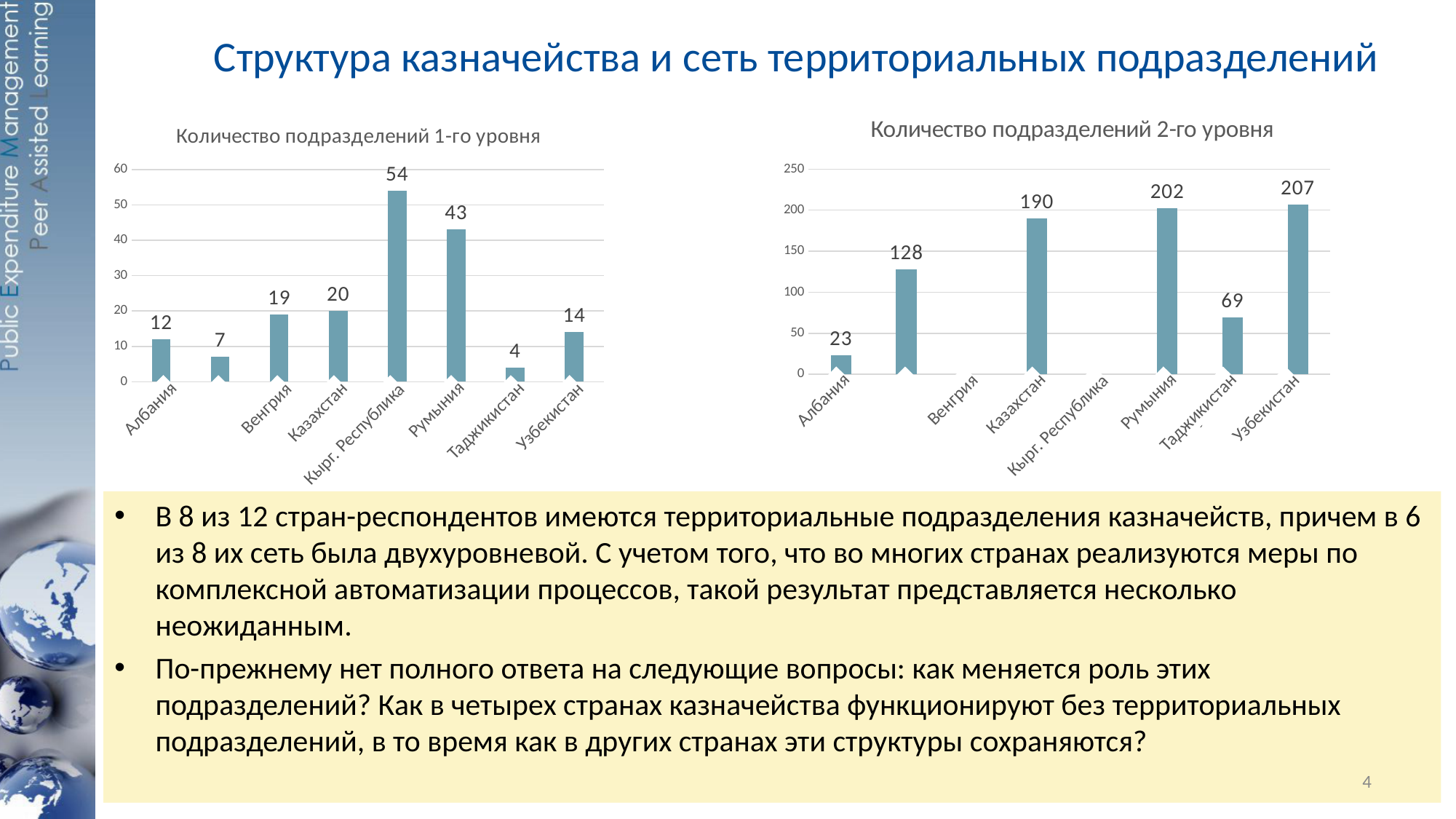
In the chart 'Количество подразделений 1-го уровня', what is the value for Румыния? 43 In the chart 'Количество подразделений 2-го уровня', what is the value for Таджикистан? 69 In the chart 'Количество подразделений 2-го уровня', which category has the highest value? Узбекистан In the chart 'Количество подразделений 2-го уровня', what is the value for Узбекистан? 207 In the chart 'Количество подразделений 1-го уровня', which category has the highest value? Кырг. Республика In the chart 'Количество подразделений 1-го уровня', what is the difference between the values for Кырг. Республика and Румыния? 11 In the chart 'Количество подразделений 2-го уровня', what is the difference between the values for Румыния and Таджикистан? 133 What type of chart is 'Количество подразделений 2-го уровня'? bar chart In the chart 'Количество подразделений 2-го уровня', which is larger, the value for Казахстан or the value for Румыния? Румыния In the chart 'Количество подразделений 1-го уровня', is the value for Албания greater or less than 10? greater In the chart 'Количество подразделений 1-го уровня', what is the value for Кырг. Республика? 54 In the chart 'Количество подразделений 1-го уровня', which category has the lowest value? Таджикистан